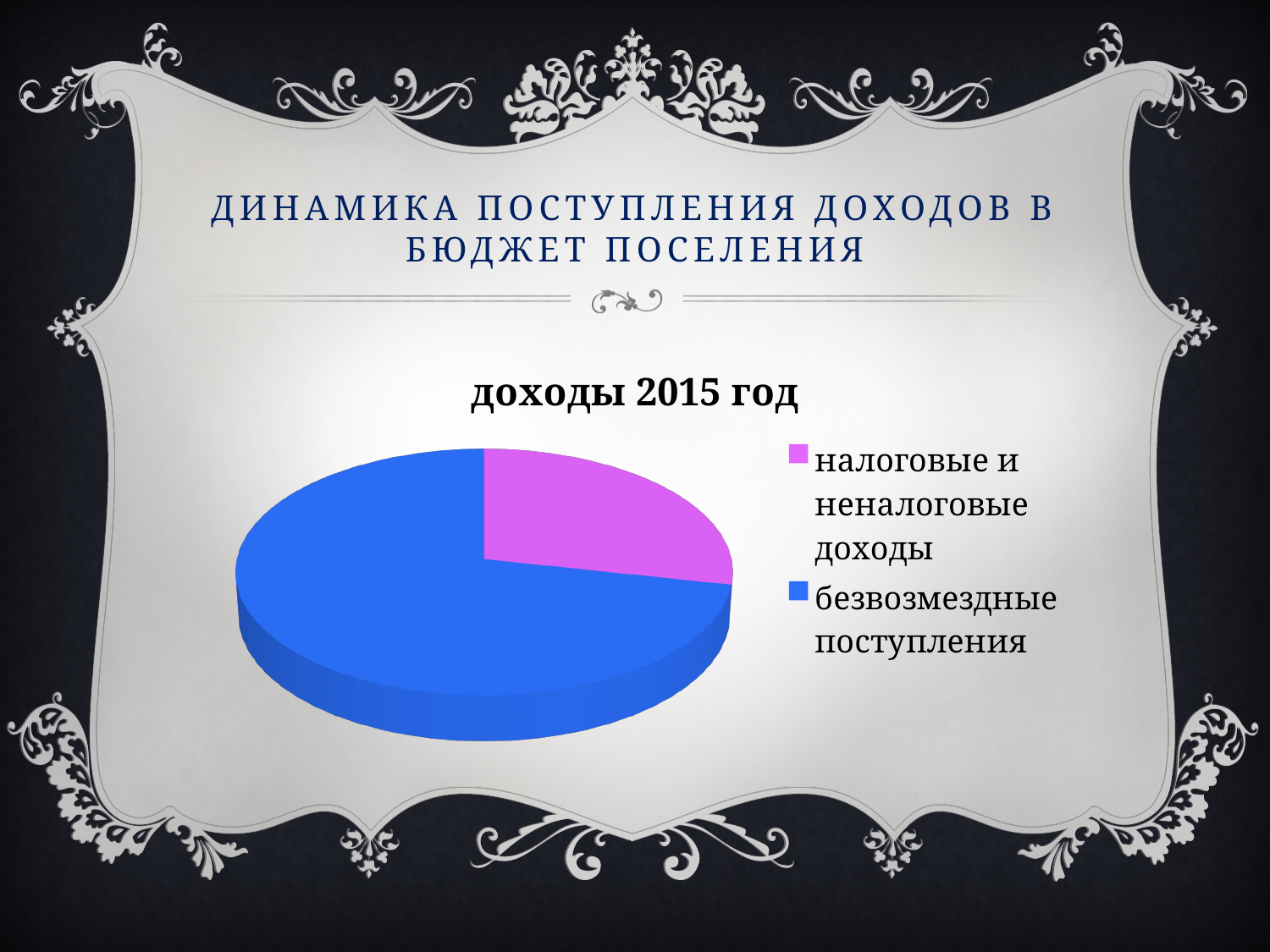
Which category has the smallest slice of the pie? налоговые и неналоговые доходы How many slices does the pie chart have? 2 Which category has the largest slice of the pie? безвозмездные поступления What colour is the slice for безвозмездные поступления? blue Which is larger: the slice for налоговые и неналоговые доходы or the slice for безвозмездные поступления? безвозмездные поступления How many entries does the chart legend list? 2 What kind of chart is shown on the slide? pie chart What is the title of the chart? доходы 2015 год